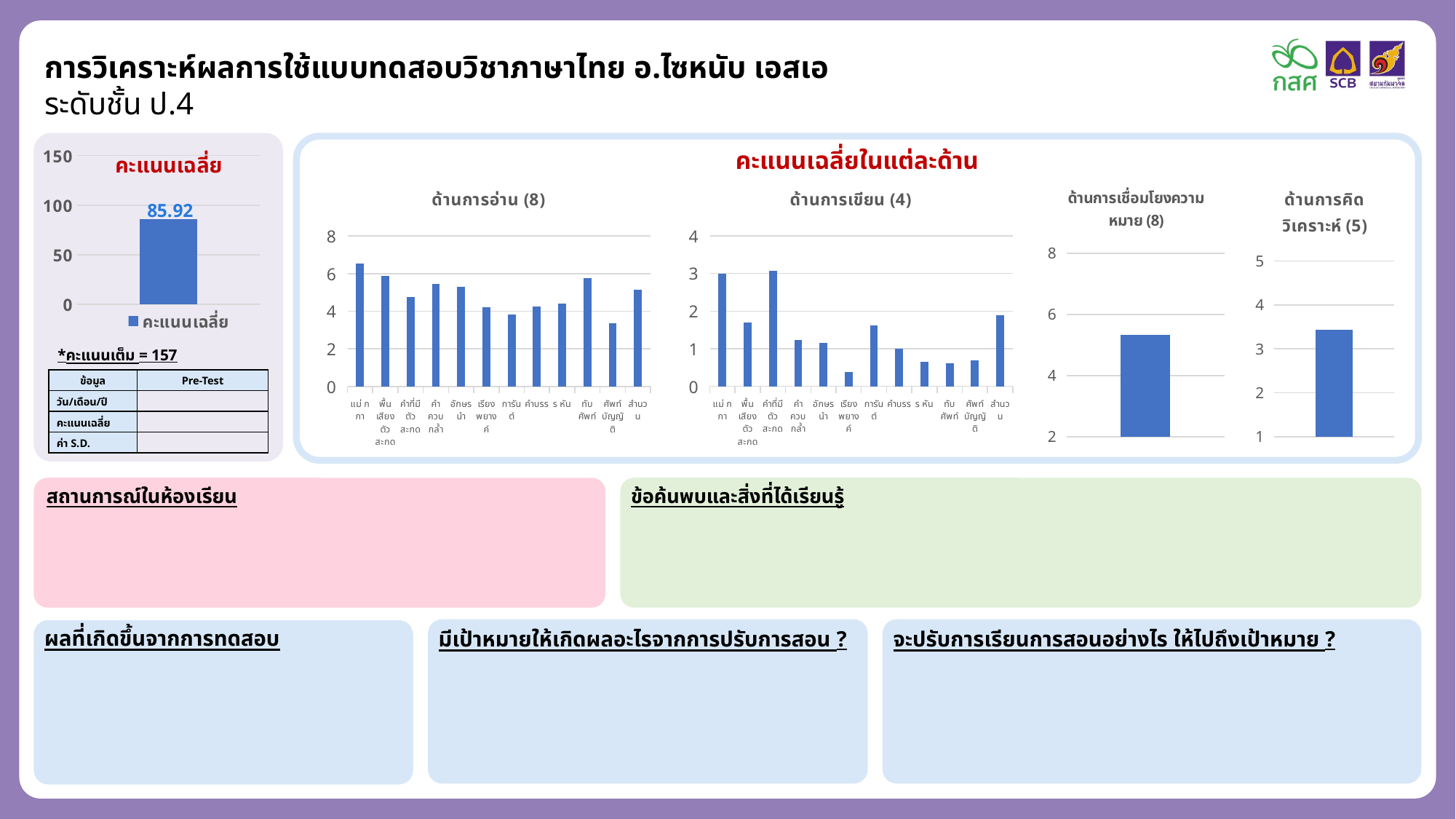
How many categories are plotted in the ด้านการอ่าน (8) chart? 12 In the ด้านการอ่าน (8) chart, is the value for ศัพท์บัญญัติ greater or less than 4? less In the ด้านการอ่าน (8) chart, is the value for แม่ กกา greater or less than 6? greater In the ด้านการอ่าน (8) chart, which category has the highest value? แม่ กกา In the ด้านการเขียน (4) chart, which category has the lowest value? เรียงพยางค์ What kind of chart is the ด้านการอ่าน (8) chart? bar chart In the ด้านการเขียน (4) chart, which is larger, the value for แม่ กกา or the value for ร หัน? แม่ กกา In the chart titled คะแนนเฉลี่ย, what entry does the legend list? คะแนนเฉลี่ย In the ด้านการอ่าน (8) chart, which category has the lowest value? ศัพท์บัญญัติ In the ด้านการเขียน (4) chart, is the value for สำนวน greater or less than 1? greater In the chart titled คะแนนเฉลี่ย, what value is shown on the bar? 85.92